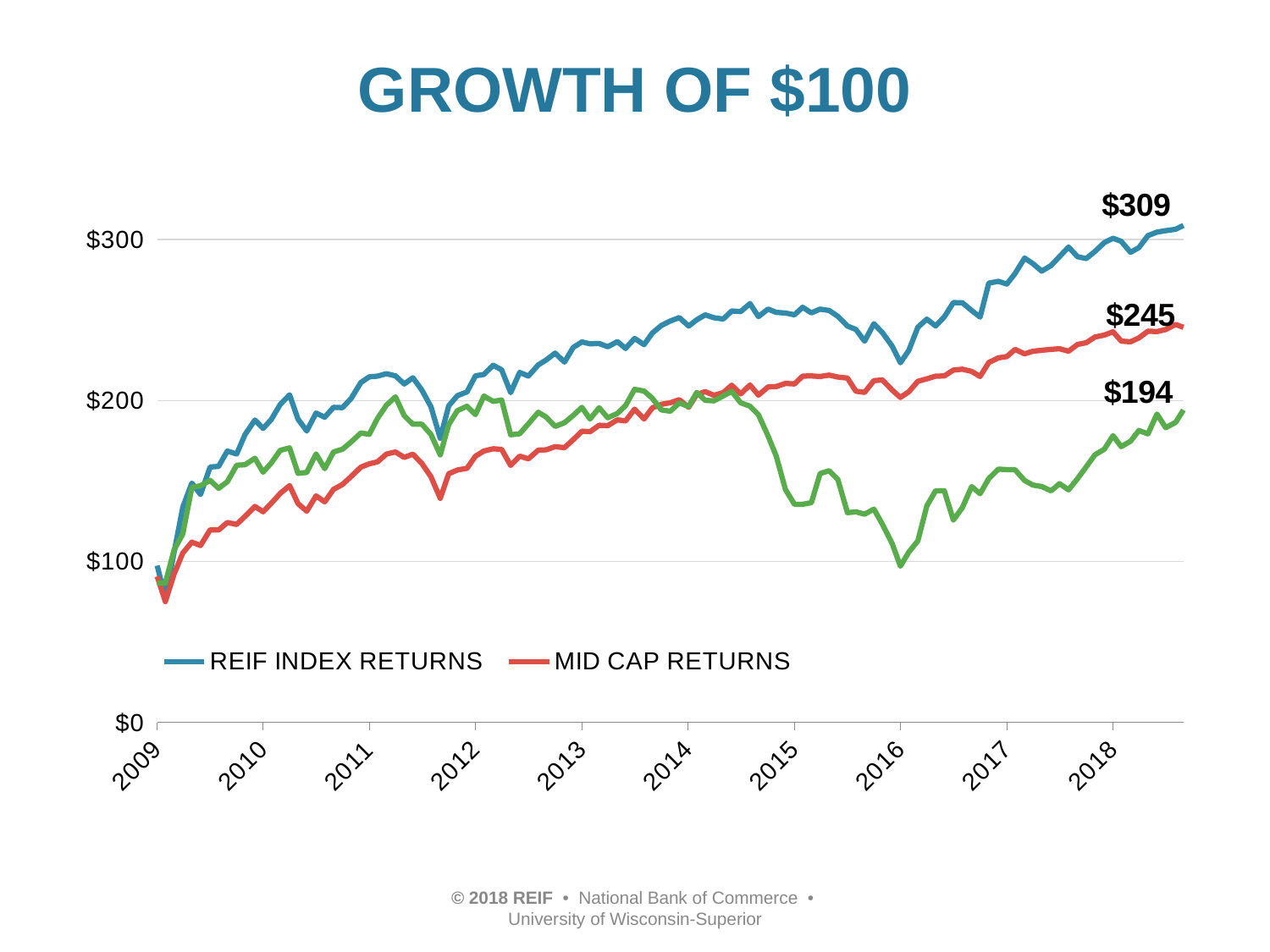
How many series does the legend list? 2 What is the final value labelled for MID CAP RETURNS? $245 What is the final value labelled for REIF INDEX RETURNS? $309 Does the REIF INDEX RETURNS line rise or fall overall from 2009 to 2018? rise What is the title of the chart? GROWTH OF $100 Is the value for MID CAP RETURNS at the start of 2012 greater or less than $200? less What kind of chart is shown on the slide? line chart Is the value for REIF INDEX RETURNS at the start of 2016 greater or less than $200? greater Which of the three end values printed on the chart is the lowest? $194 Which series ends at a higher value, REIF INDEX RETURNS or MID CAP RETURNS? REIF INDEX RETURNS What is the difference between the final values of REIF INDEX RETURNS and MID CAP RETURNS? $64 How many year labels are shown on the x axis? 10